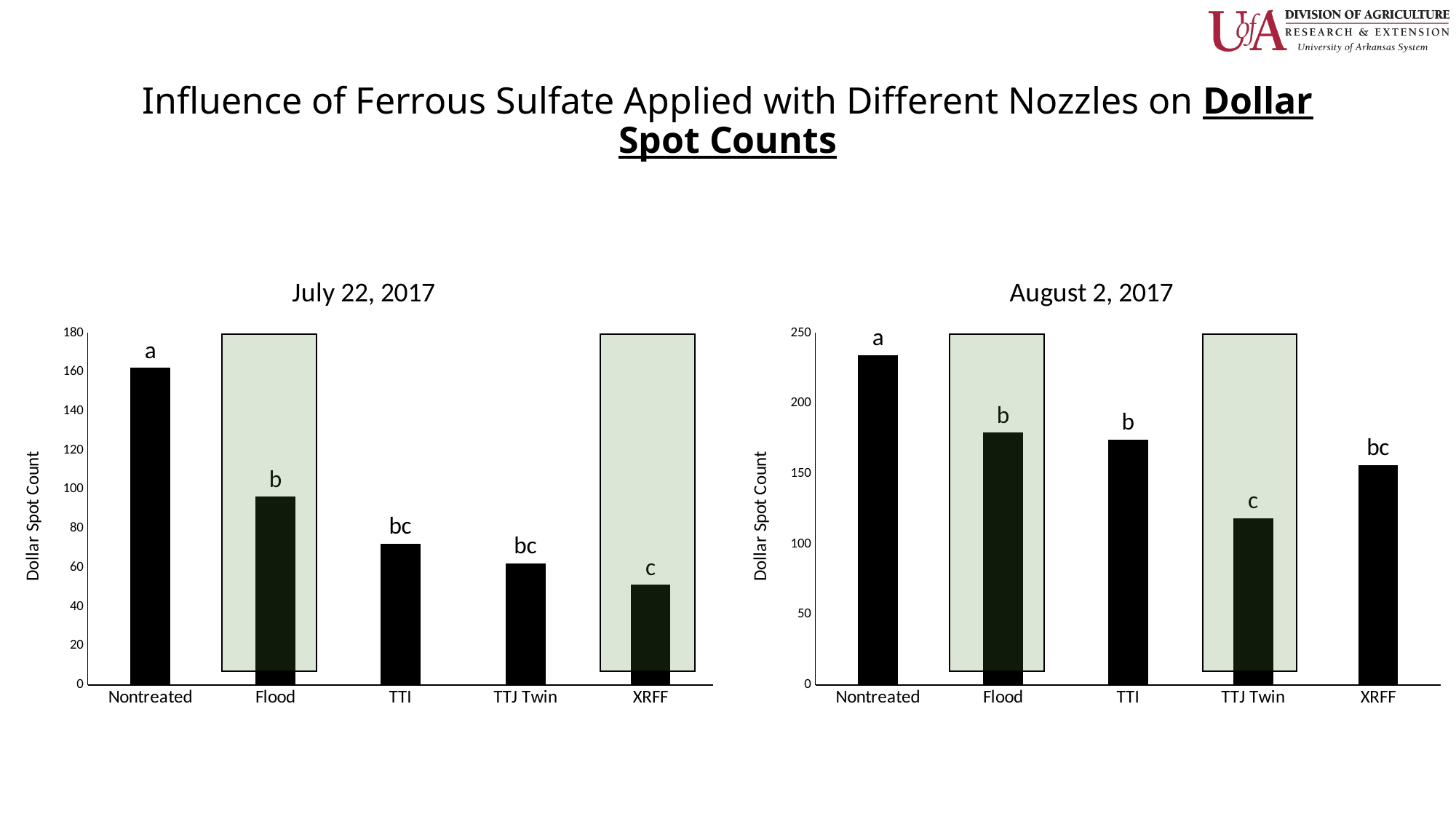
What is the y-axis label of the August 2, 2017 chart? Dollar Spot Count In the August 2, 2017 chart, which is larger, the value for XRFF or the value for TTJ Twin? XRFF In the August 2, 2017 chart, which treatment has the highest dollar spot count? Nontreated How many treatments are shown on the x axis of the August 2, 2017 chart? 5 In the July 22, 2017 chart, which treatment has the highest dollar spot count? Nontreated In the July 22, 2017 chart, is the value for Nontreated greater or less than 140? greater In the July 22, 2017 chart, which treatment has the lowest dollar spot count? XRFF In the August 2, 2017 chart, is the value for Nontreated greater or less than 200? greater In the July 22, 2017 chart, is the value for XRFF greater or less than 60? less What kind of chart is the July 22, 2017 chart? bar chart In the July 22, 2017 chart, which is larger, the value for Flood or the value for TTI? Flood In the August 2, 2017 chart, which treatment has the lowest dollar spot count? TTJ Twin